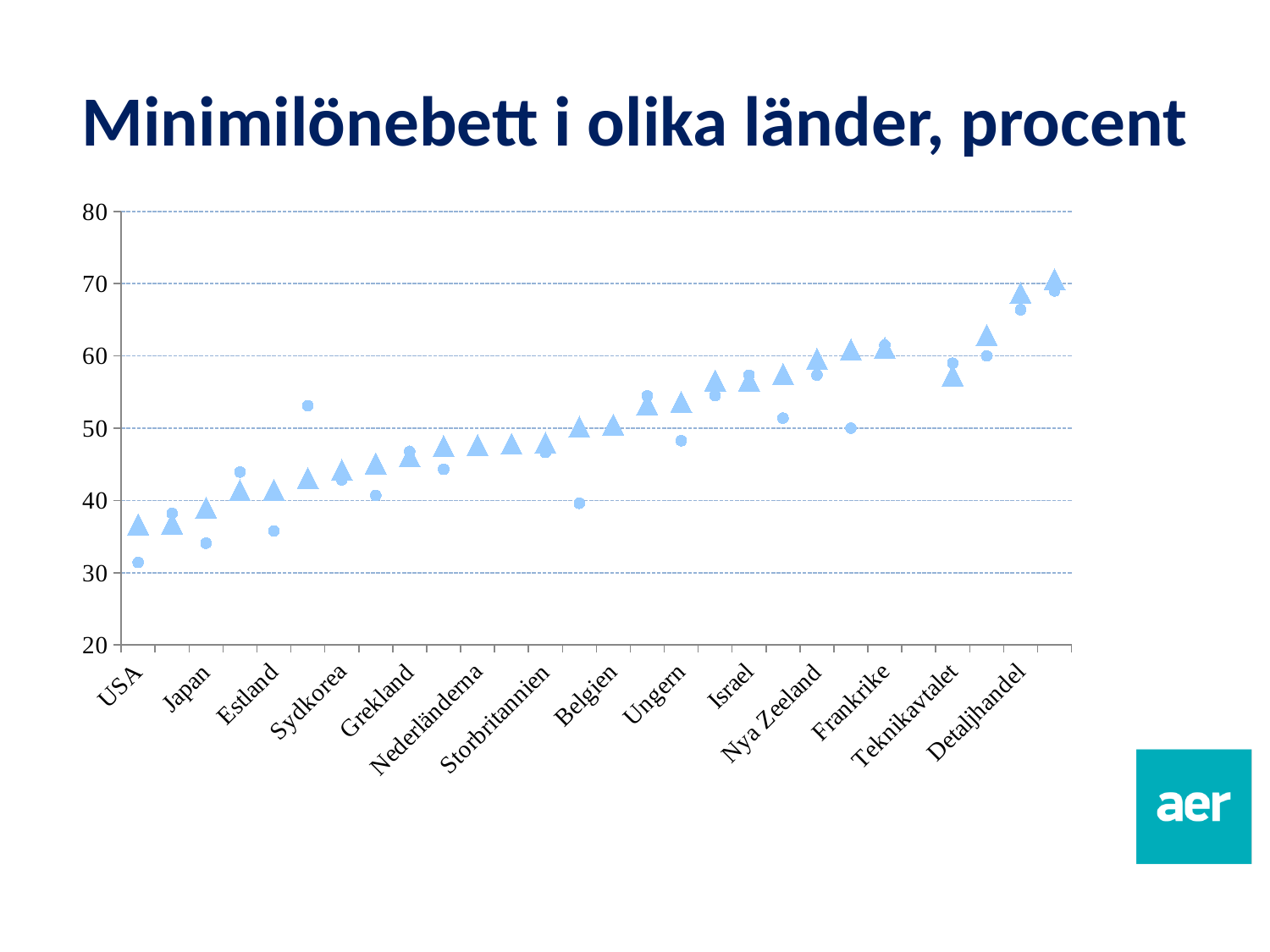
What is the title of the chart? Minimilönebett i olika länder, procent Which labelled category has the lowest plotted values? USA What kind of chart is shown on the slide? scatter chart Is the triangle-marker value for Teknikavtalet greater or less than 60? less How many category labels are shown on the x axis? 14 Is the circle-marker value for Ungern greater or less than 50? less Is the triangle-marker value for Sydkorea greater or less than 50? less Which labelled category has the highest plotted values? Detaljhandel Do the plotted values generally rise or fall from left to right along the x axis? rise